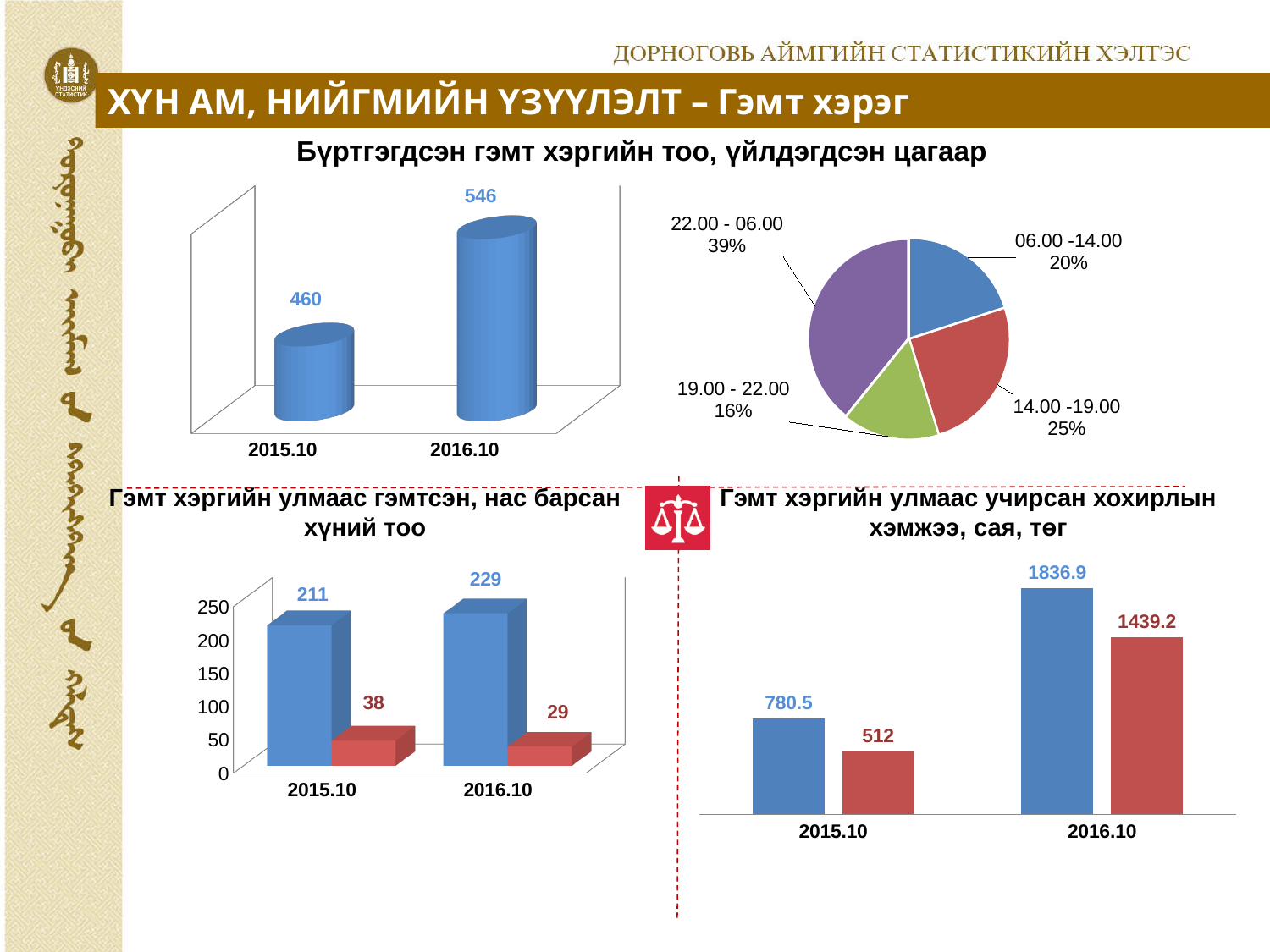
In the top-left bar chart, what is the value for 2015.10? 460 In the bottom-left chart 'Гэмт хэргийн улмаас гэмтсэн, нас барсан хүний тоо', what is the value of the red bar for 2015.10? 38 In the top-right pie chart, what share does the 22.00 - 06.00 slice have? 39% In the top-right pie chart, how many slices are there? 4 In the bottom-left chart 'Гэмт хэргийн улмаас гэмтсэн, нас барсан хүний тоо', what is the value of the blue bar for 2016.10? 229 In the bottom-right chart 'Гэмт хэргийн улмаас учирсан хохирлын хэмжээ, сая, төг', what is the difference between the blue and red bars for 2015.10? 268.5 In the top-right pie chart, which time period has the smallest share? 19.00 - 22.00 In the top-left bar chart under 'Бүртгэгдсэн гэмт хэргийн тоо, үйлдэгдсэн цагаар', what is the value for 2016.10? 546 In the bottom-right chart 'Гэмт хэргийн улмаас учирсан хохирлын хэмжээ, сая, төг', what is the value of the blue bar for 2016.10? 1836.9 In the top-left bar chart, what is the difference between the 2016.10 and 2015.10 values? 86 In the top-right pie chart, which is larger: the share for 06.00 -14.00 or the share for 14.00 -19.00? 14.00 -19.00 What type of chart is the bottom-right chart 'Гэмт хэргийн улмаас учирсан хохирлын хэмжээ, сая, төг'? bar chart